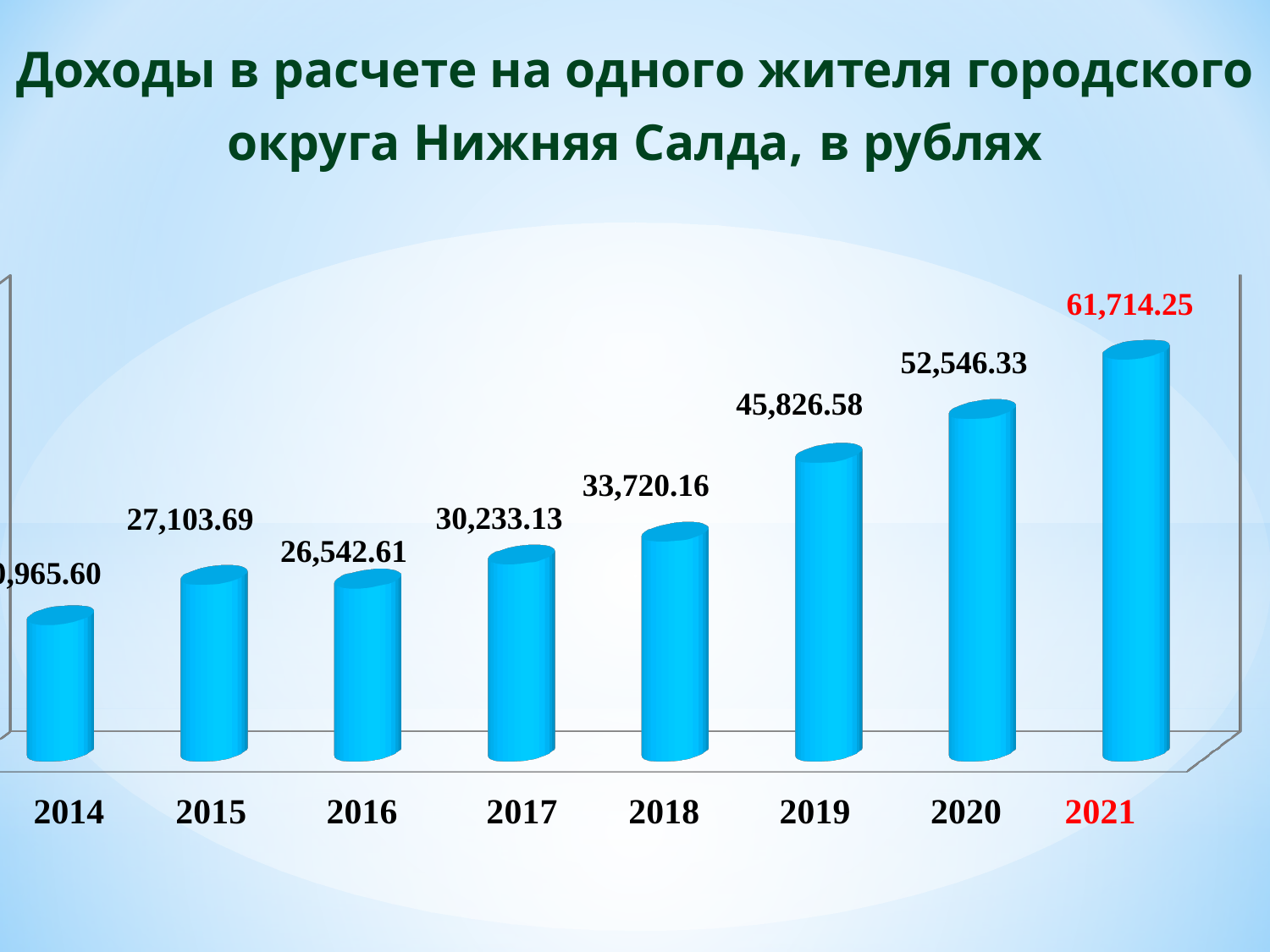
What is the value for 2020? 52,546.33 Which year has the lowest value? 2014 What kind of chart is this? Bar chart What is the value for 2018? 33,720.16 What is the value for 2021? 61,714.25 How many years are shown on the x axis? 8 Which is larger, the value for 2015 or the value for 2016? 2015 What is the value for 2016? 26,542.61 What is the difference between the values for 2019 and 2018? 12,106.42 Do the values generally rise or fall from 2014 to 2021? Rise Which year has the highest value? 2021 What is the difference between the values for 2021 and 2020? 9,167.92